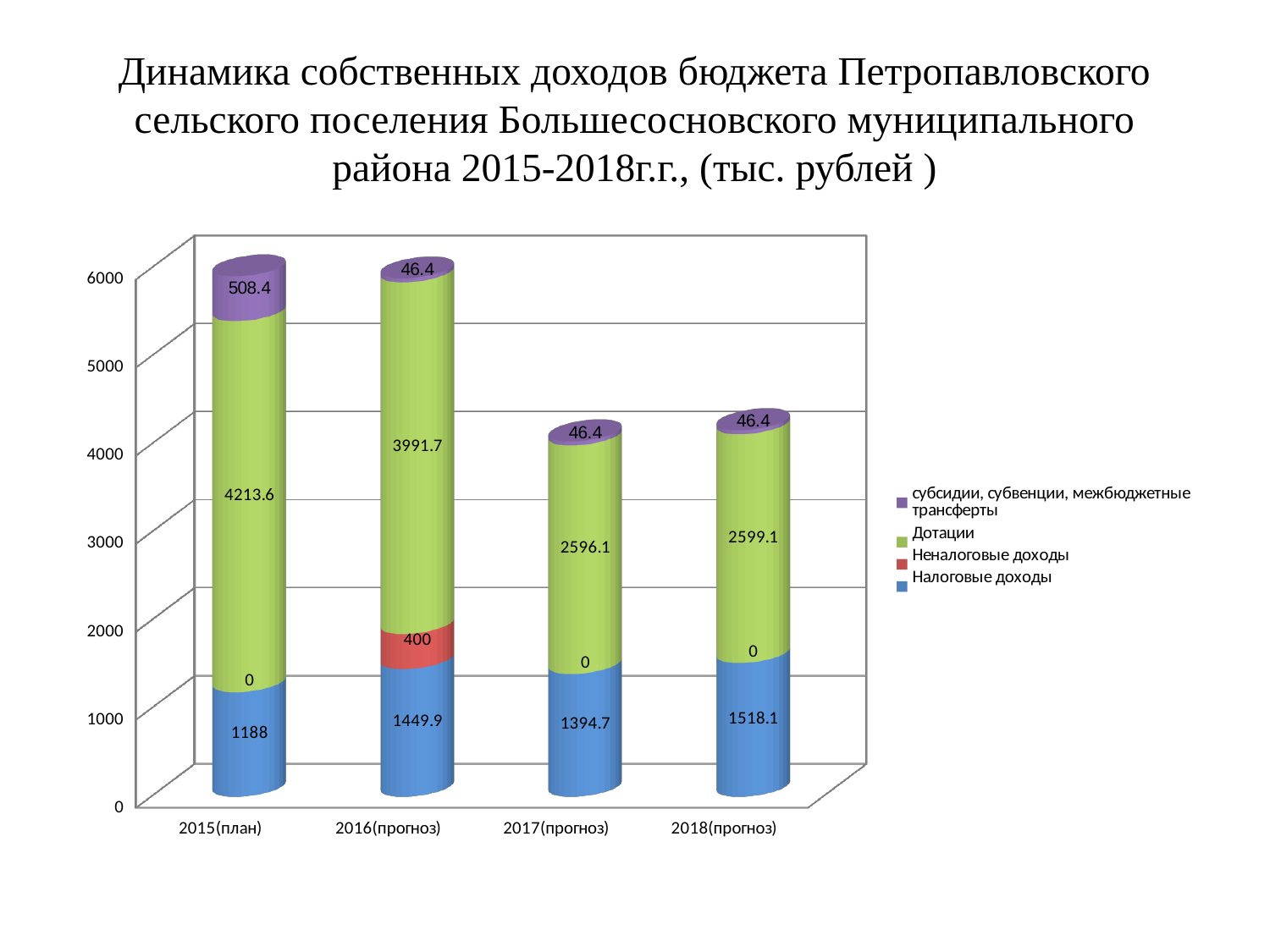
What is the value of субсидии, субвенции, межбюджетные трансферты for 2015(план)? 508.4 What is the total of the stacked bar for 2017(прогноз)? 4037.2 What kind of chart is shown on the slide? Stacked bar chart How many series does the legend list? 4 What is the value of Дотации for 2016(прогноз)? 3991.7 Which year has the lowest value of Дотации? 2017(прогноз) Which year has the highest value of Налоговые доходы? 2018(прогноз) Which is larger: Налоговые доходы in 2016(прогноз) or in 2017(прогноз)? 2016(прогноз) What is the value of Неналоговые доходы for 2016(прогноз)? 400 What is the difference between Дотации in 2015(план) and 2016(прогноз)? 221.9 What is the value of Налоговые доходы for 2015(план)? 1188 How many years are shown on the x axis? 4